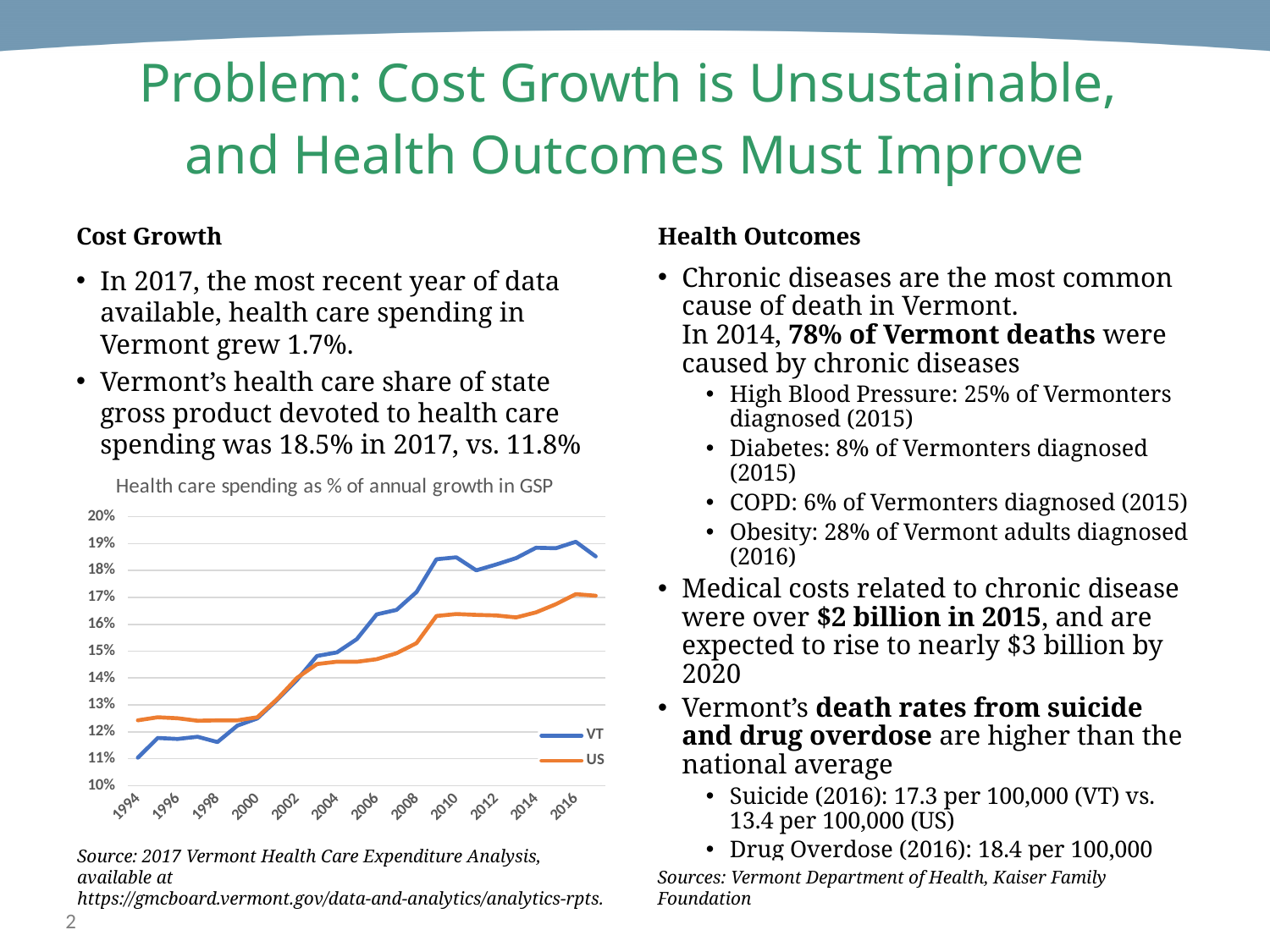
Is the value for US in 2008 greater or less than 16%? less Is the value for VT in 1994 greater or less than 12%? less What kind of chart is shown on the slide? line chart Is the value for VT in 2010 greater or less than 18%? greater Which series is drawn in orange in the chart? US How many series does the chart's legend list? 2 In 1994, which series has the higher value, VT or US? US What is the title of the chart? Health care spending as % of annual growth in GSP Does the VT series generally rise or fall from 1994 to 2016? rise In 2016, which series has the higher value, VT or US? VT